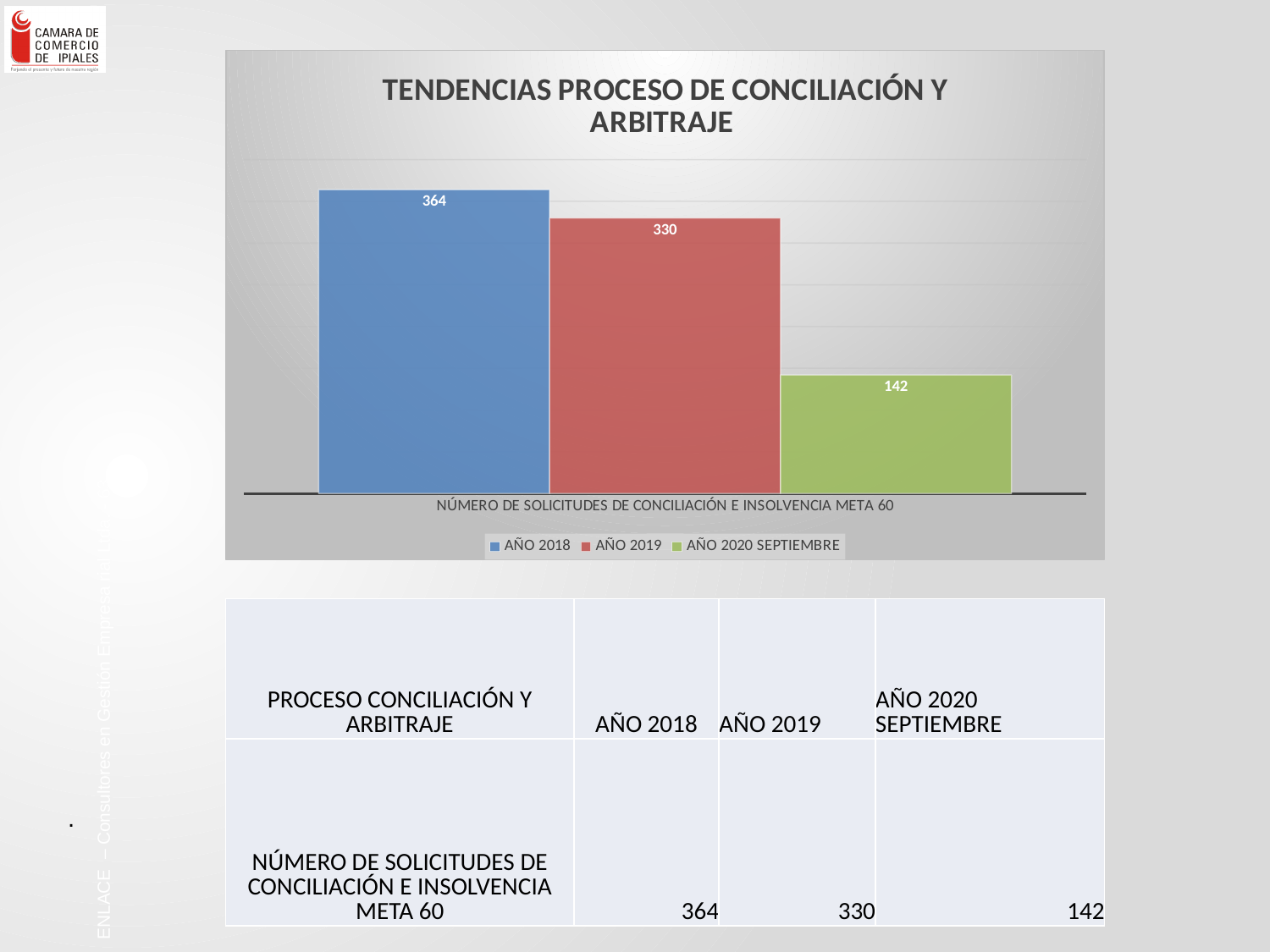
What is the difference between the values for AÑO 2018 and AÑO 2019? 34 Which is larger, the value for AÑO 2019 or the value for AÑO 2020 SEPTIEMBRE? AÑO 2019 Which series has the highest value in the chart? AÑO 2018 What is the value for AÑO 2019 in the chart? 330 What kind of chart is shown on the slide? Bar chart What is the value for AÑO 2018 in the chart? 364 What is the title of the chart? TENDENCIAS PROCESO DE CONCILIACIÓN Y ARBITRAJE Do the values rise or fall from AÑO 2018 to AÑO 2020 SEPTIEMBRE? Fall What is the difference between the values for AÑO 2019 and AÑO 2020 SEPTIEMBRE? 188 What is the value for AÑO 2020 SEPTIEMBRE in the chart? 142 Which series has the lowest value in the chart? AÑO 2020 SEPTIEMBRE How many series does the legend list? 3